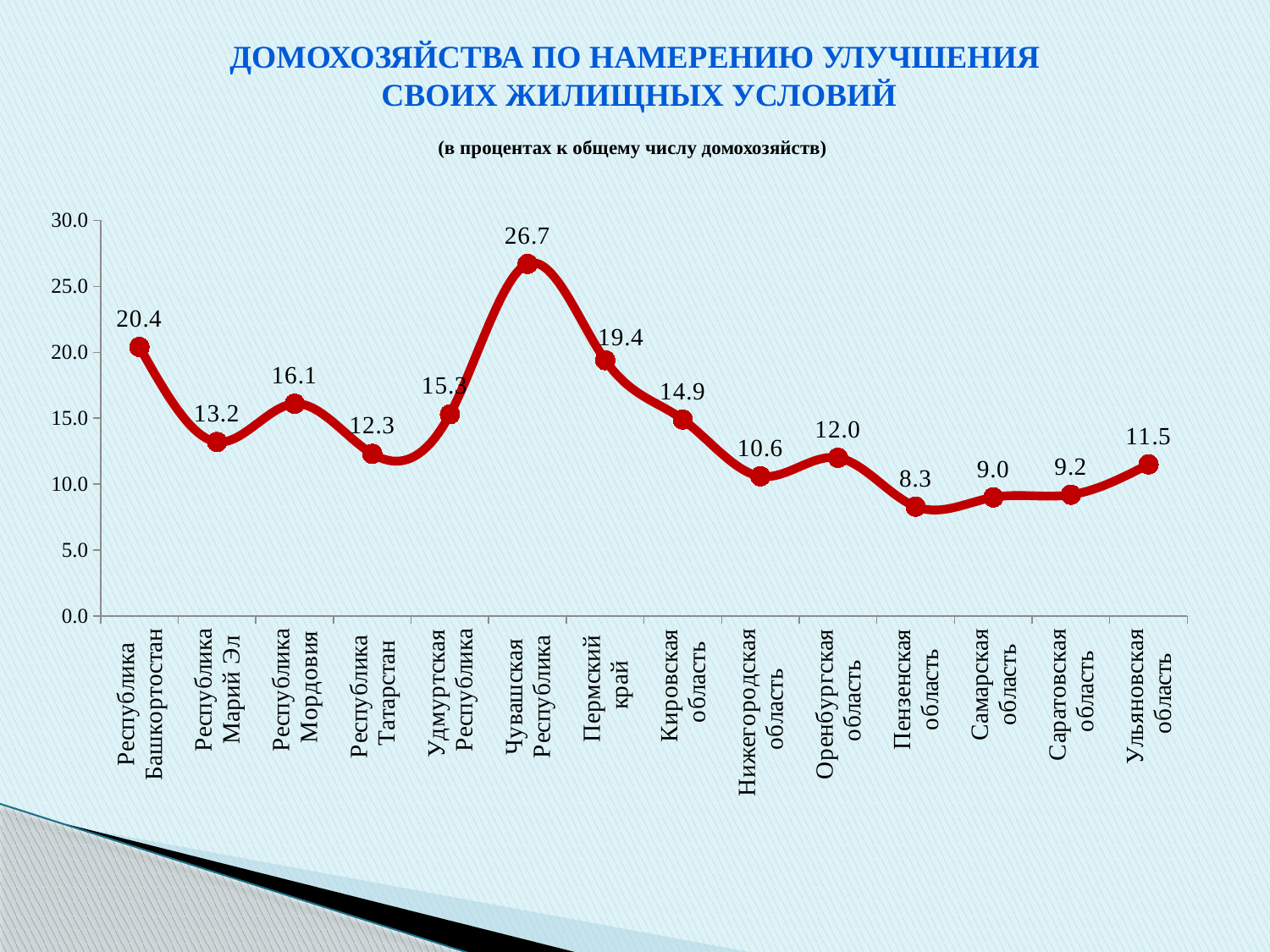
Do the values rise or fall from Пензенская область to Ульяновская область? rise What is the value for Чувашская Республика? 26.7 Which region has the highest value? Чувашская Республика What is the value for Пензенская область? 8.3 How many regions are plotted on the chart? 14 Which region has the lowest value? Пензенская область What is the difference between the values for Республика Башкортостан and Республика Марий Эл? 7.2 Is the value for Кировская область greater or less than 10.0? greater Which is larger, the value for Республика Мордовия or the value for Удмуртская Республика? Республика Мордовия What is the difference between the values for Чувашская Республика and Пермский край? 7.3 What kind of chart is shown on the slide? line chart What is the value for Республика Башкортостан? 20.4